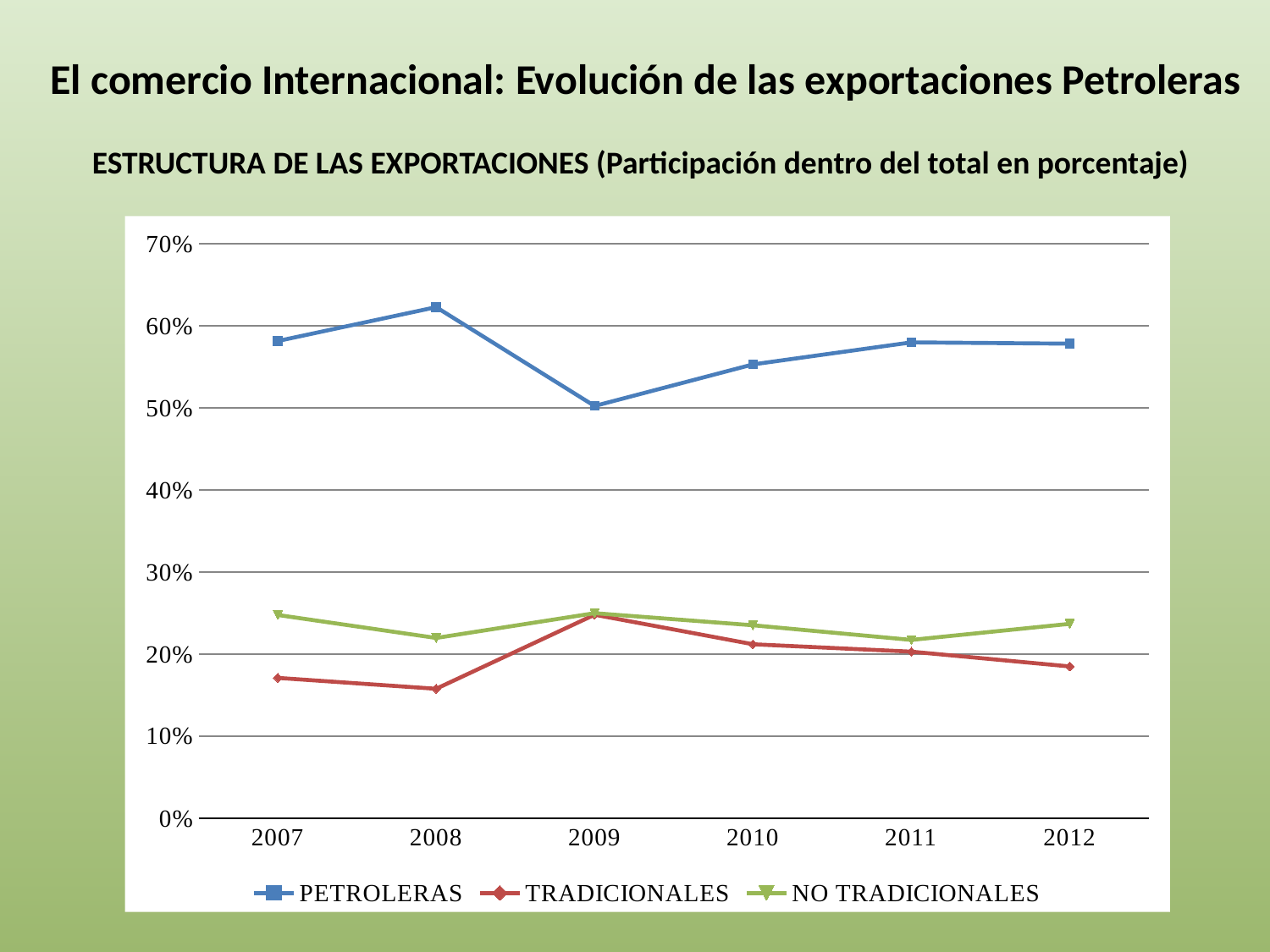
Is the PETROLERAS value for 2008 greater or less than 60%? greater In 2007, which is larger: TRADICIONALES or NO TRADICIONALES? NO TRADICIONALES In which year is the PETROLERAS share highest? 2008 What colour is the PETROLERAS line? Blue Does the TRADICIONALES line rise or fall from 2009 to 2012? Fall Is the NO TRADICIONALES value for 2011 greater or less than 30%? less Is the TRADICIONALES value for 2008 greater or less than 20%? less What kind of chart is shown on the slide? Line chart In which year is the PETROLERAS share lowest? 2009 How many series does the legend list? 3 How many years are plotted along the x axis? 6 In which year is the TRADICIONALES share highest? 2009